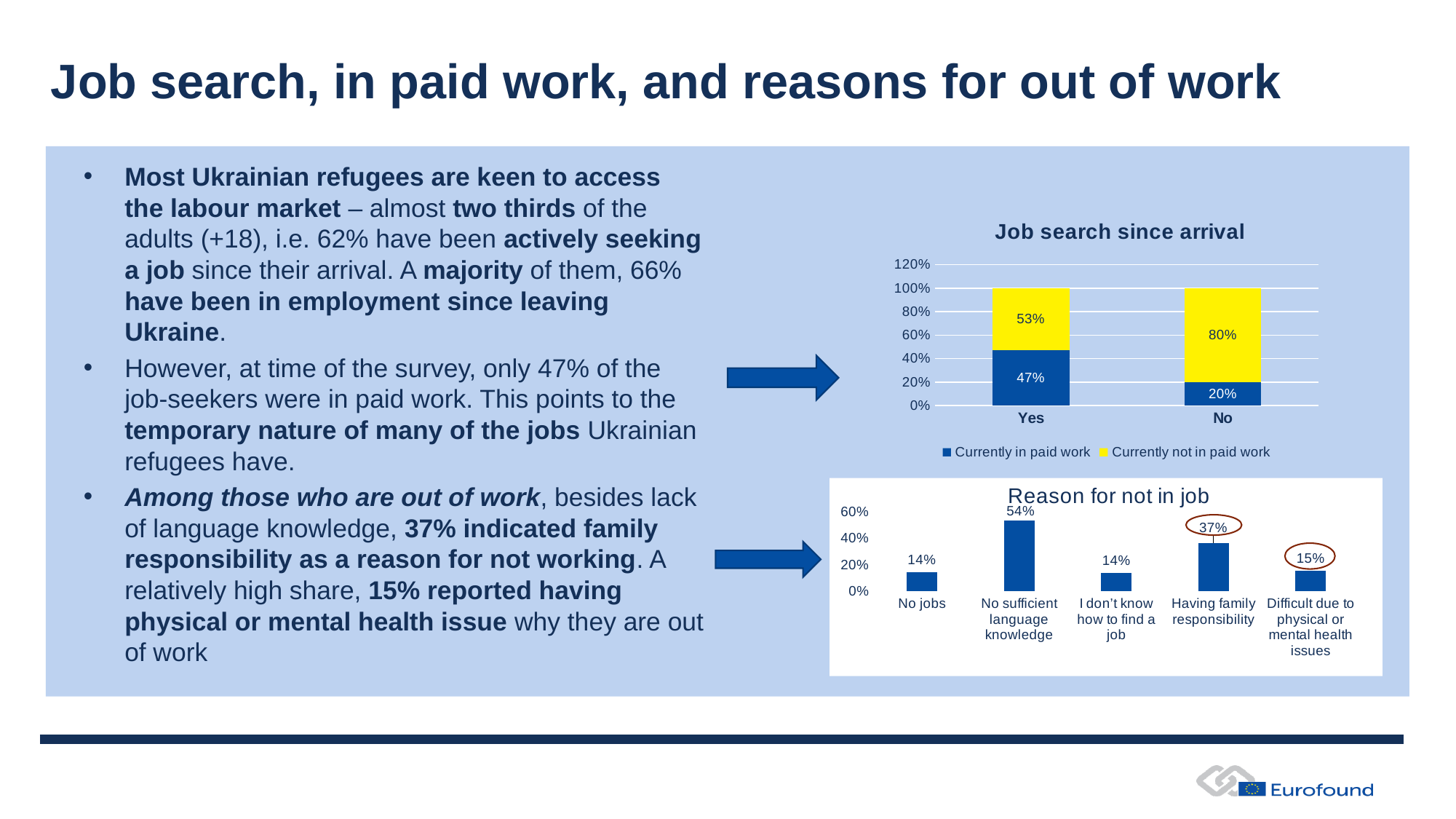
In the 'Job search since arrival' chart, what colour represents 'Currently not in paid work'? Yellow What kind of chart is the 'Reason for not in job' chart? Bar chart In the 'Job search since arrival' chart, what is the difference between the 'Currently not in paid work' values for 'No' and 'Yes'? 27% In the 'Reason for not in job' chart, what is the value for 'Having family responsibility'? 37% In the 'Job search since arrival' chart, what is the total of the stacked bar for 'Yes'? 100% In the 'Reason for not in job' chart, which reason has the highest value? No sufficient language knowledge In the 'Job search since arrival' chart, what is the value for 'Currently in paid work' in the 'Yes' category? 47% In the 'Job search since arrival' chart, what is the value for 'Currently not in paid work' in the 'No' category? 80% In the 'Reason for not in job' chart, how many reasons are shown on the x axis? 5 In the 'Job search since arrival' chart, which category has the larger 'Currently in paid work' value, 'Yes' or 'No'? Yes In the 'Reason for not in job' chart, what is the difference between 'No sufficient language knowledge' and 'Having family responsibility'? 17% In the 'Job search since arrival' chart, how many series does the legend list? 2